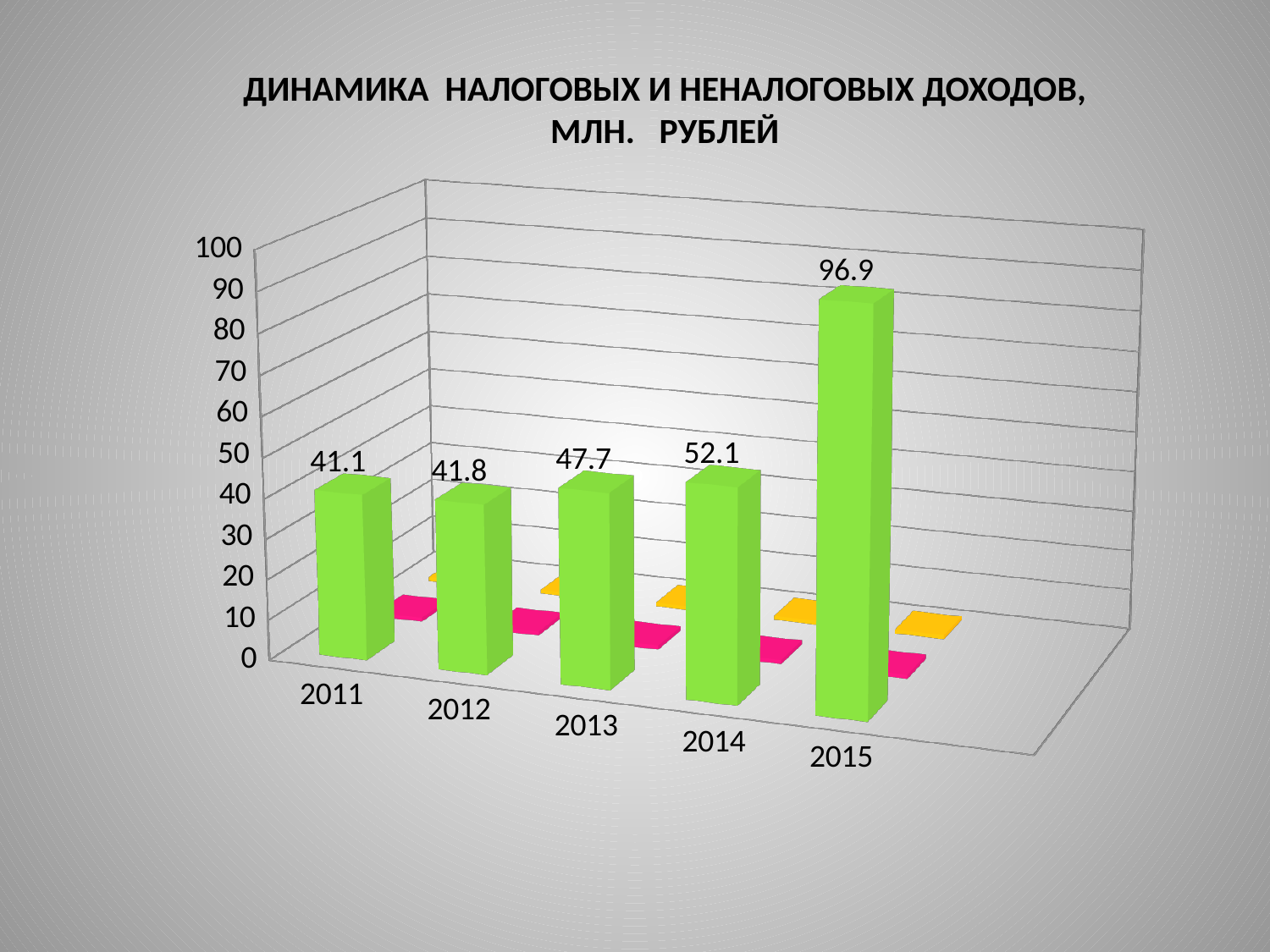
What is the value of the green bar for 2015? 96.9 Do the green bar values rise or fall from 2011 to 2015? rise Which is larger, the green bar for 2013 or the green bar for 2014? 2014 What is the value of the green bar for 2011? 41.1 How many years are shown on the x axis? 5 What kind of chart is shown on the slide? bar chart What is the value of the green bar for 2013? 47.7 Which year has the lowest green bar? 2011 What is the difference between the green bar values for 2012 and 2011? 0.7 Is the green bar value for 2015 greater or less than 90? greater What is the difference between the green bar values for 2015 and 2014? 44.8 Which year has the highest green bar? 2015